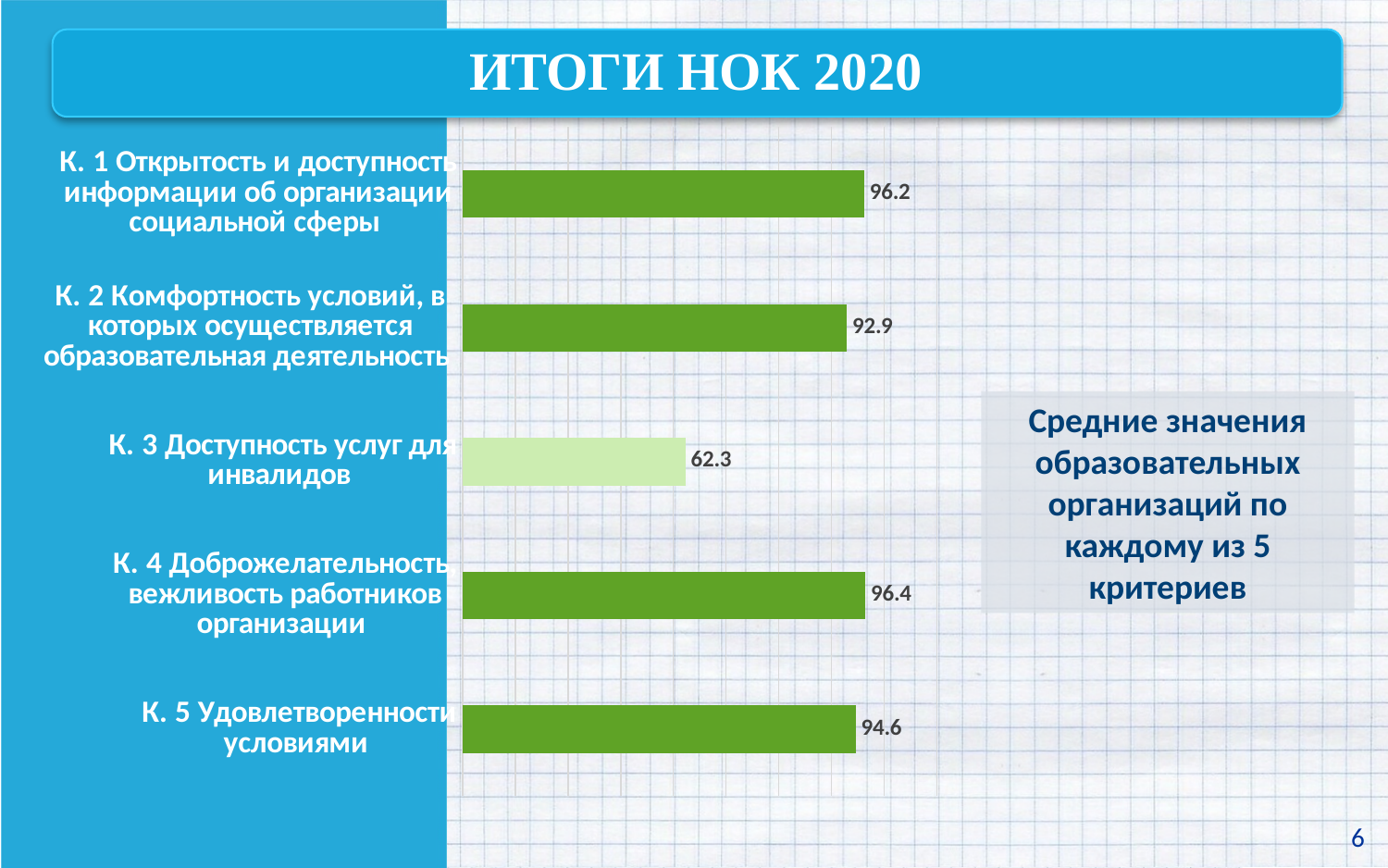
Which criterion has the highest value? К. 4 Доброжелательность, вежливость работников организации How many criteria are shown in the chart? 5 Which bar is shown in a lighter green colour than the others? К. 3 Доступность услуг для инвалидов What is the value for К. 3 Доступность услуг для инвалидов? 62.3 What is the value for К. 2 Комфортность условий, в которых осуществляется образовательная деятельность? 92.9 What kind of chart is shown on the slide? Bar chart Which criterion has the lowest value? К. 3 Доступность услуг для инвалидов What is the difference between the values for К. 4 and К. 3? 34.1 What is the value for К. 1 Открытость и доступность информации об организации социальной сферы? 96.2 Which has a larger value, К. 2 or К. 5? К. 5 Удовлетворенность условиями What is the value for К. 5 Удовлетворенность условиями? 94.6 What is the difference between the values for К. 1 and К. 2? 3.3